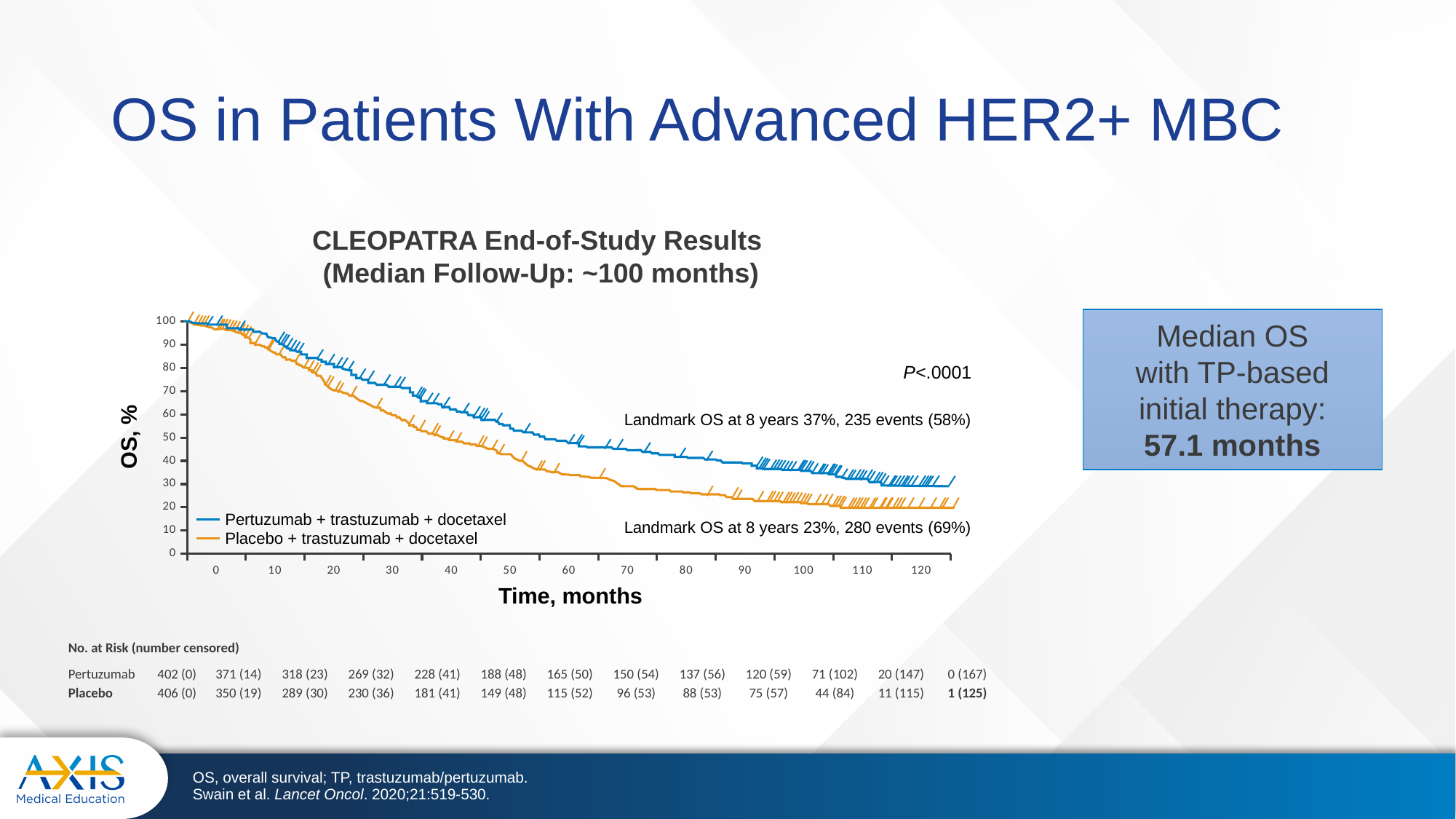
What is the difference in landmark OS at 8 years between the pertuzumab arm and the placebo arm? 14 percentage points What is the landmark OS at 8 years for the pertuzumab + trastuzumab + docetaxel arm? 37% What is the landmark OS at 8 years for the placebo + trastuzumab + docetaxel arm? 23% How many placebo patients were at risk at 100 months? 44 (84) How many pertuzumab patients were at risk at 0 months? 402 (0) Is the OS value for the pertuzumab + trastuzumab + docetaxel curve at 40 months greater or less than 60%? greater Which arm has the higher landmark OS at 8 years? Pertuzumab + trastuzumab + docetaxel What kind of chart is shown on the slide? Line chart (Kaplan-Meier survival curve) What is the P value shown on the chart? P<.0001 How many series does the legend list? 2 How many events were reported in the placebo + trastuzumab + docetaxel arm? 280 (69%) Do the survival curves rise or fall as time increases along the x axis? Fall